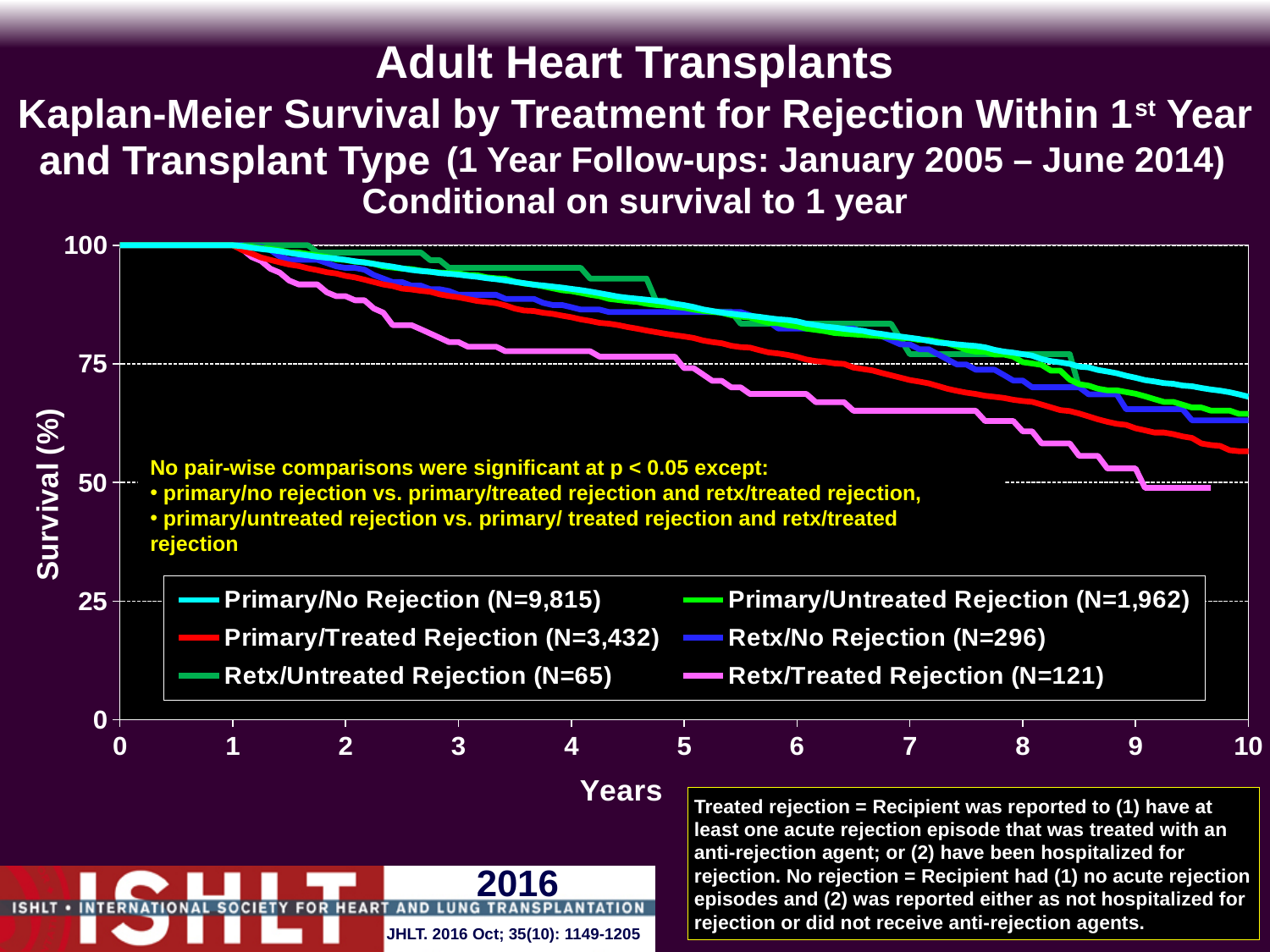
At 6 years, which has higher survival: Primary/No Rejection or Retx/Treated Rejection? Primary/No Rejection Which legend group has the largest N? Primary/No Rejection (N=9,815) What is the sample size (N) shown in the legend for Retx/Untreated Rejection? N=65 How many series does the legend list? 6 Which series has the lowest survival at 8 years? Retx/Treated Rejection What kind of chart is shown on the slide? Line chart What is the sample size (N) shown in the legend for Primary/No Rejection? N=9,815 Which legend group has the smallest N? Retx/Untreated Rejection (N=65) Is the survival value for Retx/Treated Rejection at 7 years greater or less than 75? less Is the survival value for Primary/Treated Rejection at 10 years greater or less than 50? greater Do the survival curves rise or fall as years increase? Fall Is the survival value for Primary/No Rejection at 5 years greater or less than 75? greater